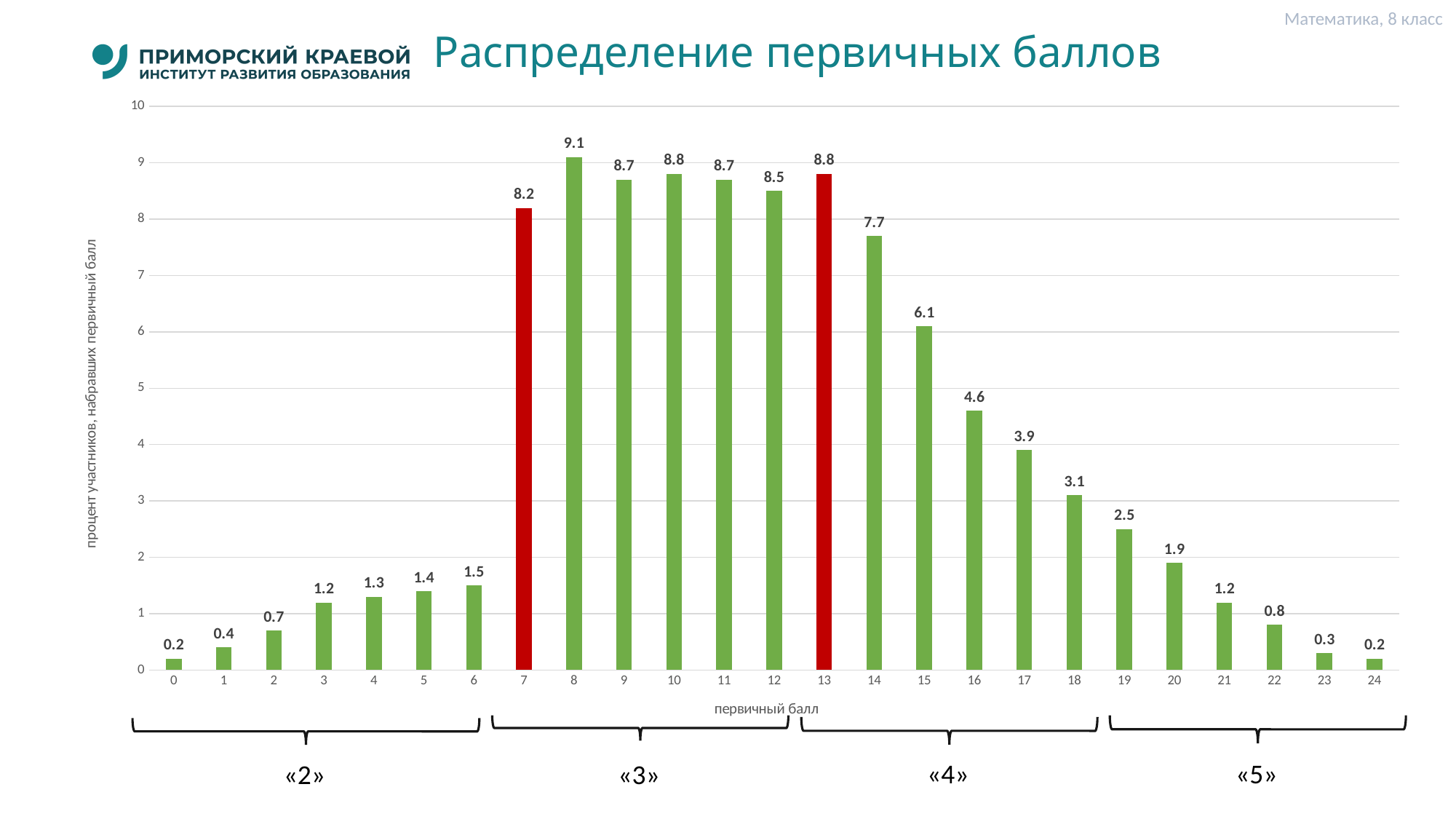
What type of chart is shown on the slide? bar chart Which is larger, the value for primary score 6 or the value for primary score 19? 19 What is the difference between the values for primary scores 13 and 14? 1.1 Which primary score has the highest value? 8 What is the value for primary score 7? 8.2 How many primary score categories are shown on the x axis? 25 Do the values rise or fall along the x axis from primary score 14 to 24? fall Is the value for primary score 16 greater or less than 5? less What is the value for primary score 8? 9.1 What is the value for primary score 15? 6.1 What is the title of the chart? Распределение первичных баллов Which primary scores are shown with red bars? 7 and 13